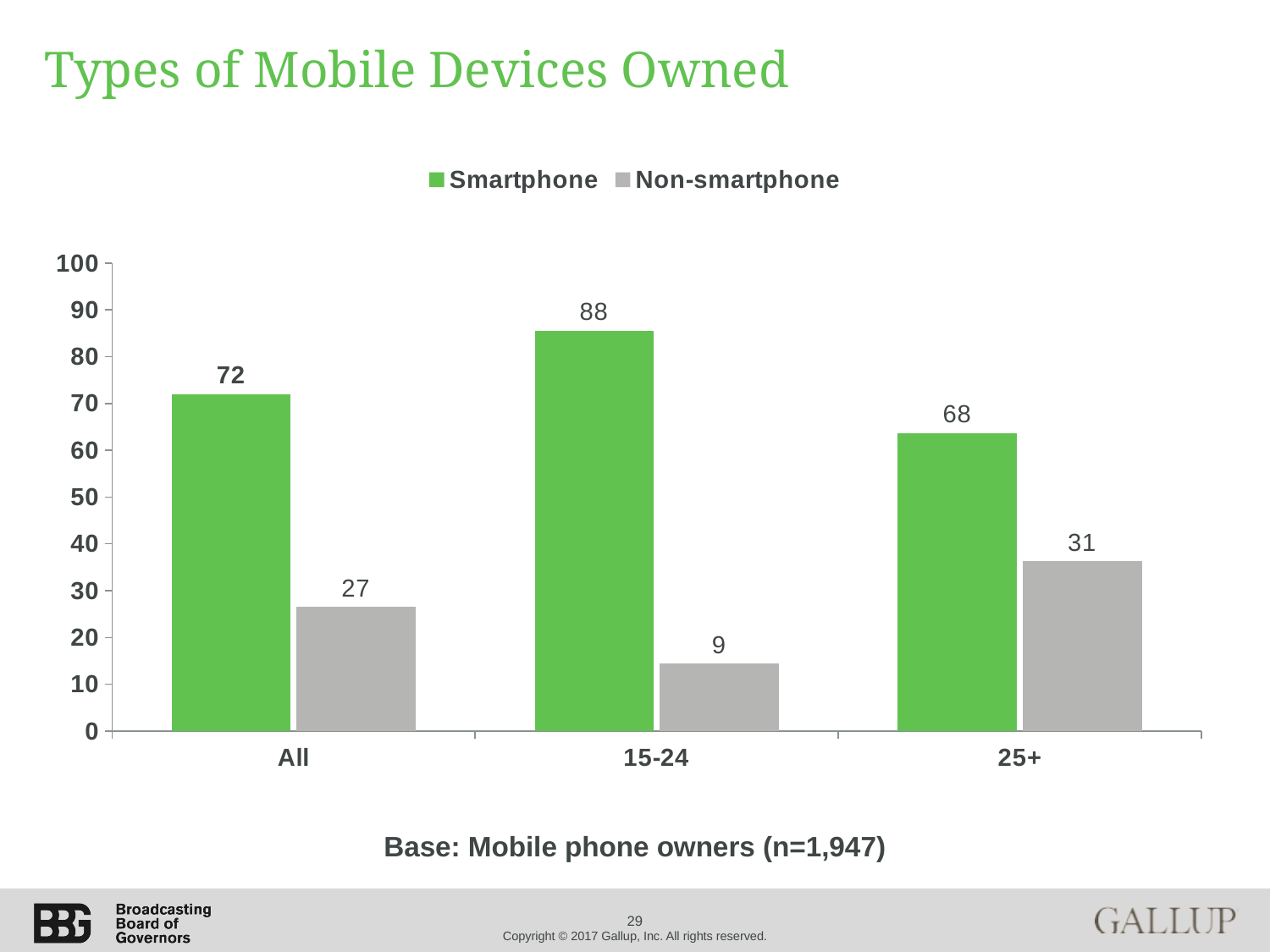
How many series does the legend list? 2 Which group has the lowest Non-smartphone value? 15-24 What is the difference between the Smartphone and Non-smartphone values for the 25+ group? 37 What is the Non-smartphone value for the 25+ group? 31 What kind of chart is shown? bar chart Is the Smartphone value for 25+ greater or less than 60? greater How many groups are shown on the x axis? 3 Which is larger: the Non-smartphone value for All or for 25+? 25+ What is the Smartphone value for All? 72 Which group has the highest Smartphone value? 15-24 What colour represents the Non-smartphone series? grey What is the Smartphone value for the 15-24 group? 88